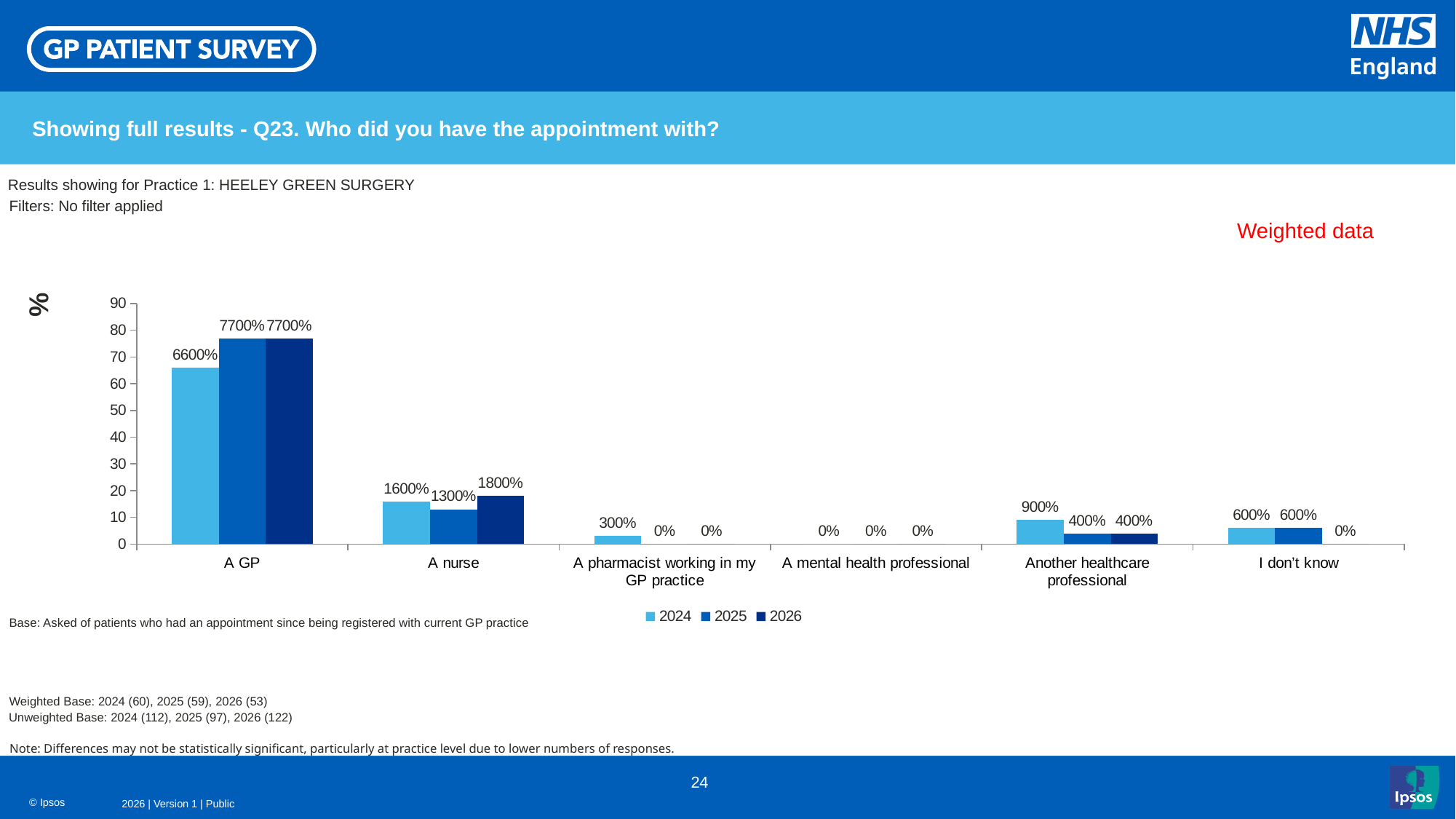
What is the difference between the 2025 and 2024 values for A GP? 1100% Which series is shown in the darkest blue in the legend? 2026 How many series does the legend list? 3 What is the value for A GP in 2024? 6600% What kind of chart is shown on the slide? Bar chart What is the value for I don't know in 2026? 0% Which category has the highest value in 2025? A GP How many categories are shown on the x axis? 6 Which is larger for A nurse: the 2024 value or the 2025 value? 2024 Which category has the lowest value in 2024? A mental health professional What is the value for Another healthcare professional in 2024? 900% What is the value for A nurse in 2026? 1800%